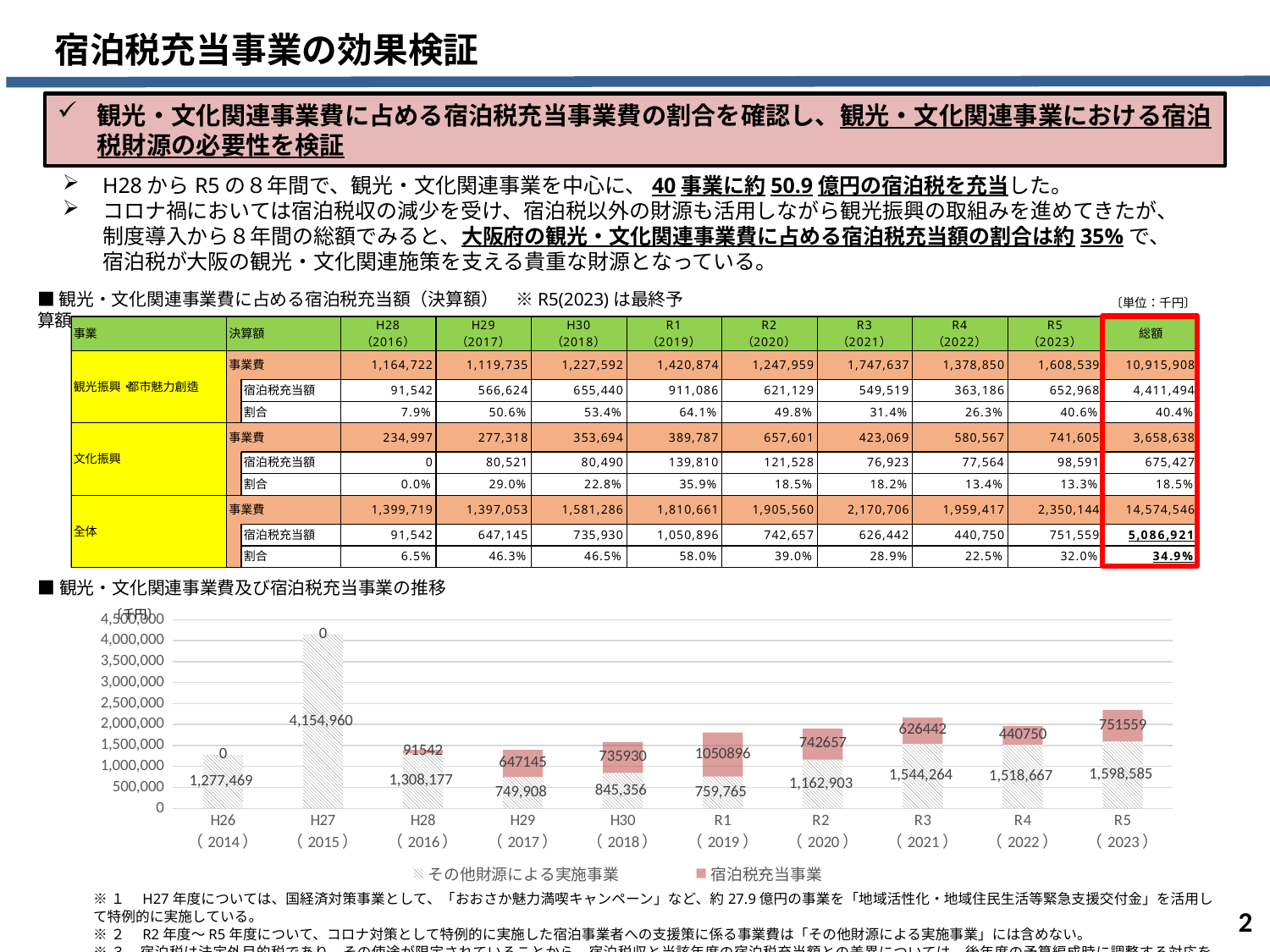
Which year has the highest value for その他財源による実施事業? H27 (2015) What is the difference between the 宿泊税充当事業 values for R5 (2023) and R4 (2022)? 310809 What is the value of 宿泊税充当事業 for R5 (2023)? 751559 Which year has the highest value for 宿泊税充当事業? R1 (2019) How many series does the chart's legend list? 2 What is the value of 宿泊税充当事業 for R1 (2019)? 1050896 What kind of chart is shown on the slide? stacked bar chart What is the value of その他財源による実施事業 for H27 (2015)? 4,154,960 What is the total of the stacked bar for H29 (2017)? 1,397,053 Which is larger, the その他財源による実施事業 value for R3 (2021) or for R2 (2020)? R3 (2021) How many fiscal-year categories are shown on the x axis of the chart? 10 Is the total height of the H27 (2015) bar greater or less than 4,000,000? greater